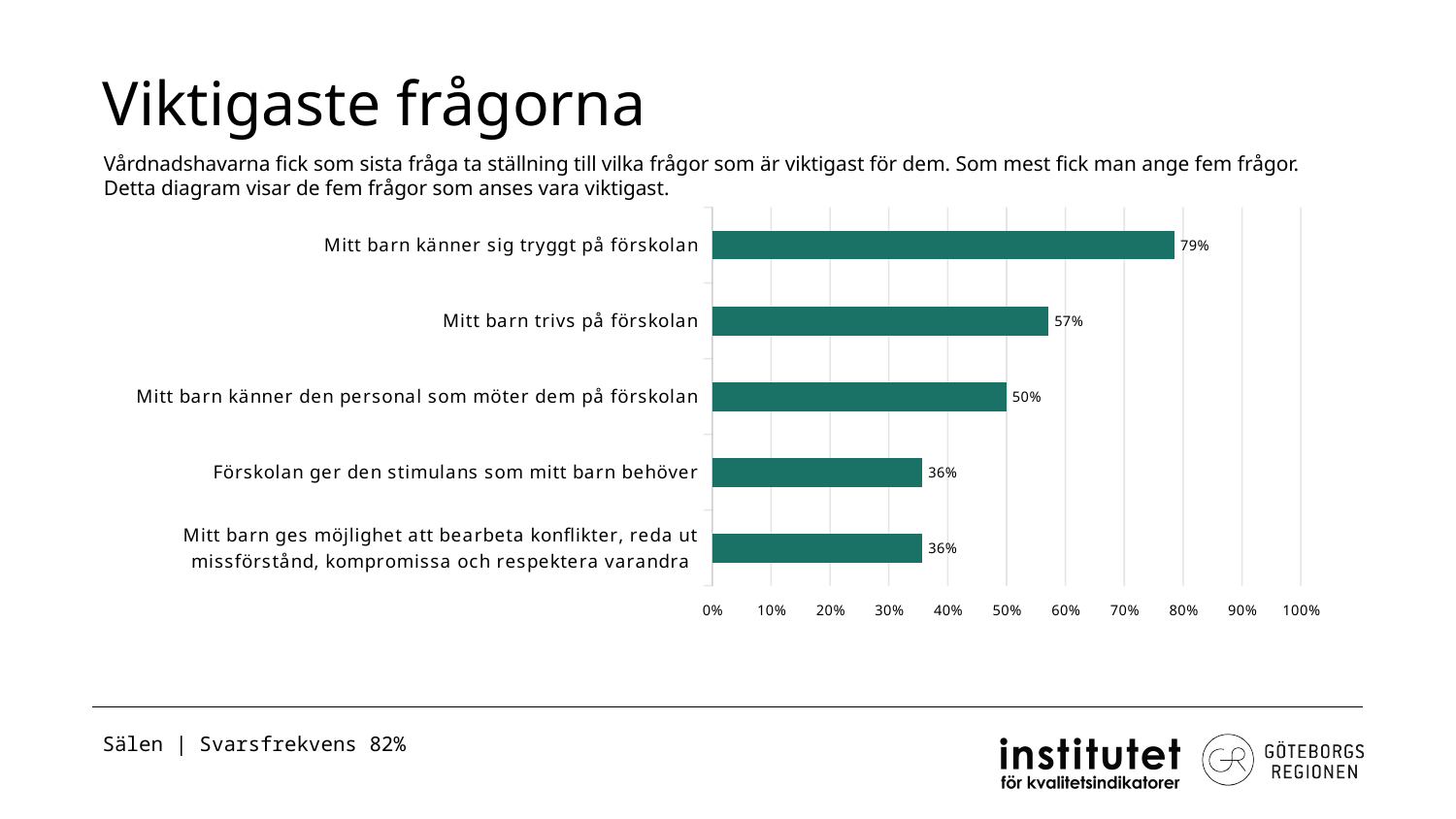
What is the title of the slide containing the chart? Viktigaste frågorna Is the value for "Mitt barn känner sig tryggt på förskolan" greater or less than 70%? greater What is the difference between the values for "Mitt barn trivs på förskolan" and "Mitt barn känner den personal som möter dem på förskolan"? 7% What kind of chart is shown on the slide? Bar chart How many categories are shown in the chart? 5 What is the value for "Mitt barn känner sig tryggt på förskolan"? 79% What is the difference between the values for "Mitt barn känner sig tryggt på förskolan" and "Mitt barn trivs på förskolan"? 22% What is the value for "Mitt barn känner den personal som möter dem på förskolan"? 50% Which is larger: the value for "Mitt barn trivs på förskolan" or for "Förskolan ger den stimulans som mitt barn behöver"? Mitt barn trivs på förskolan Which category has the highest value? Mitt barn känner sig tryggt på förskolan What is the value for "Förskolan ger den stimulans som mitt barn behöver"? 36% What is the value for "Mitt barn trivs på förskolan"? 57%